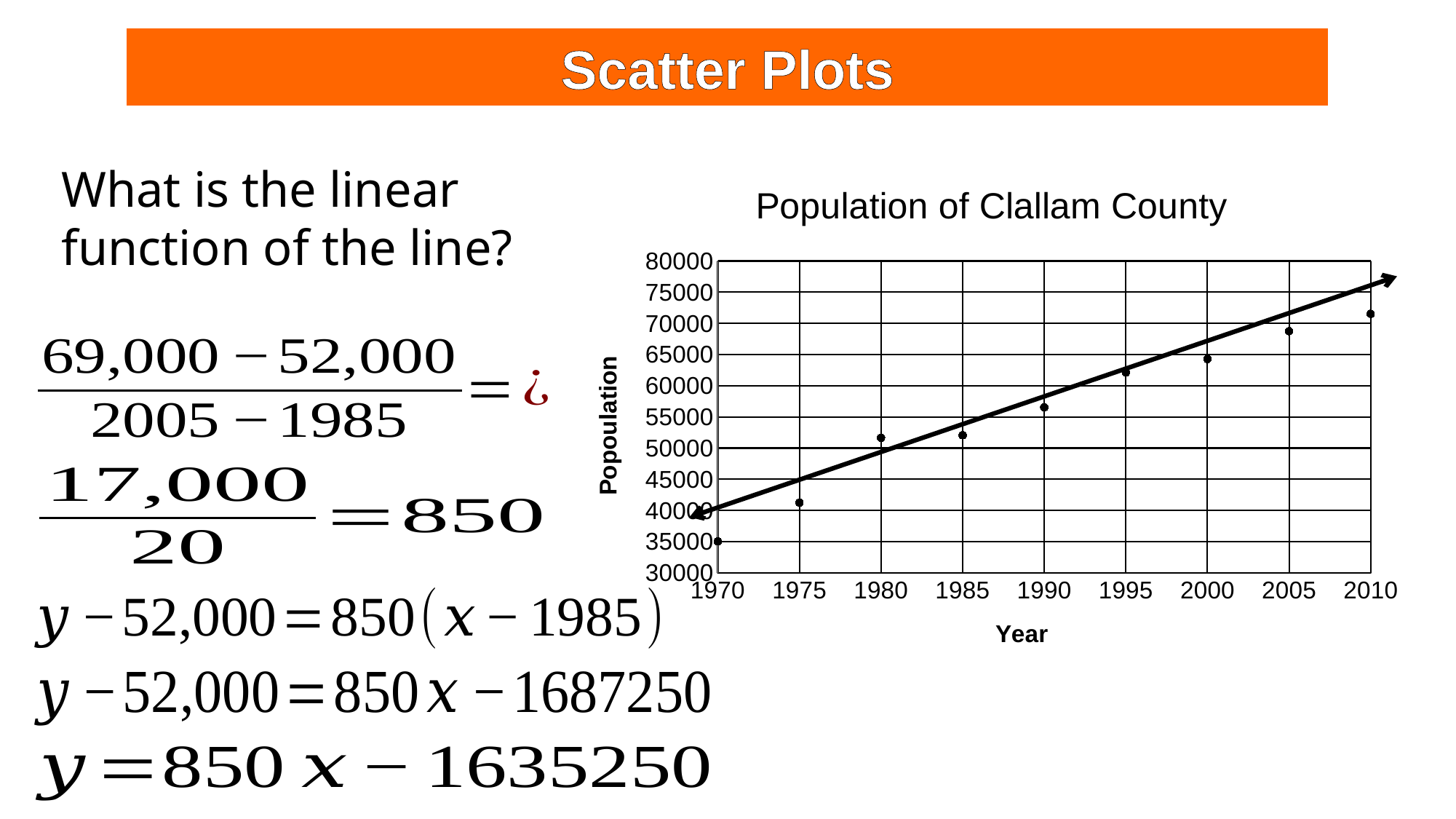
Is the population value for 1995 greater or less than 60000? greater Is the population value for 2010 greater or less than 70000? greater What is the title of the chart? Population of Clallam County Is the population value for 1970 greater or less than 40000? less Which year has the lowest plotted population? 1970 Do the plotted population values rise or fall as the year increases? Rise How many data points are plotted on the chart? 9 Which year has the highest plotted population? 2010 Which year has the larger plotted population, 1990 or 2005? 2005 What is the label of the vertical axis of the chart? Popoulation What kind of chart is shown on the slide? Scatter plot